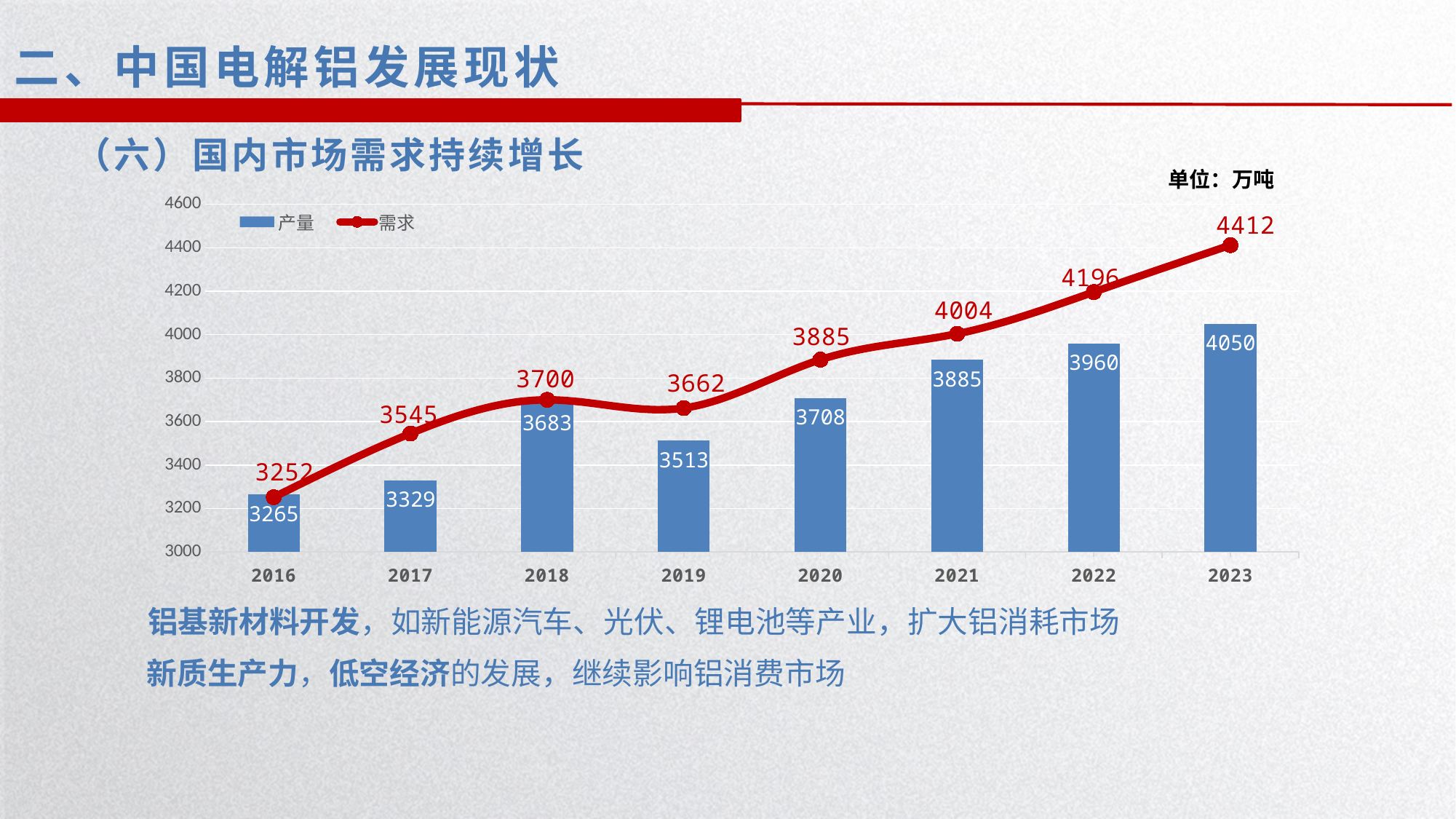
How many years are shown on the x axis? 8 What is the 产量 value for 2016? 3265 What is the 需求 value for 2022? 4196 How many series does the legend list? 2 Which year has the highest 需求 value? 2023 Does the 需求 line generally rise or fall from 2016 to 2023? rise What is the difference between the 需求 and 产量 values in 2023? 362 What is the 产量 value for 2019? 3513 What is the difference between the 产量 values for 2018 and 2019? 170 Which year has the lowest 产量 value? 2016 In 2017, which is larger, 产量 or 需求? 需求 What unit is stated for the chart values? 万吨